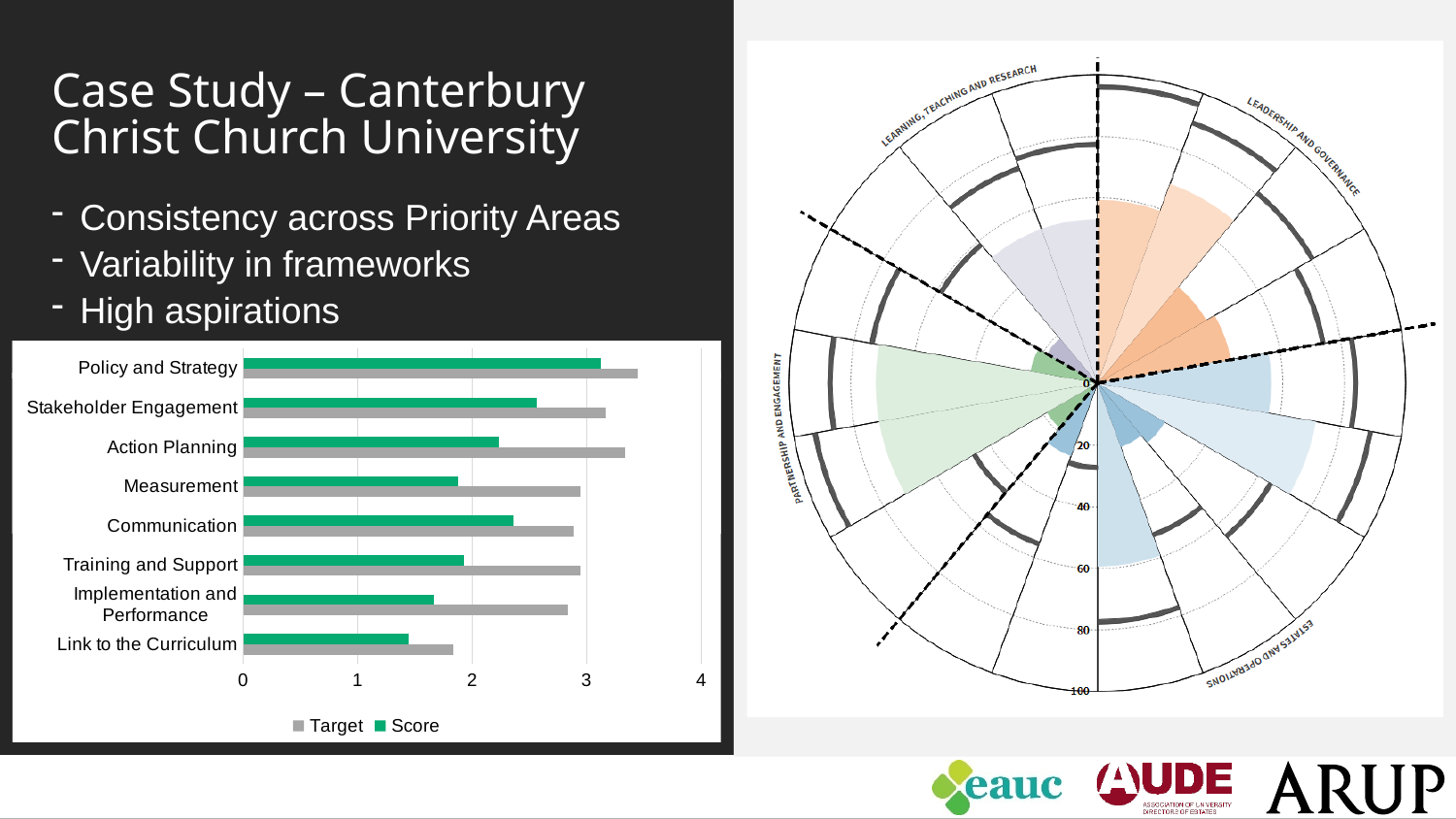
In the bar chart on the left, how many series does the legend list? 2 In the bar chart on the left, which category has the highest Score? Policy and Strategy In the bar chart on the left, which category has the lowest Score? Link to the Curriculum In the bar chart on the left, which is larger: the Score for Policy and Strategy or the Score for Link to the Curriculum? Policy and Strategy In the bar chart on the left, is the Target for Link to the Curriculum greater or less than 2? less In the bar chart on the left, is the Target for Policy and Strategy greater or less than 3? greater In the bar chart on the left, for Action Planning, which is larger: the Target or the Score? Target In the bar chart on the left, how many categories are shown? 8 In the bar chart on the left, what kind of chart is it? bar chart In the bar chart on the left, which category has the lowest Target? Link to the Curriculum In the bar chart on the left, what are the two legend entries? Target and Score In the bar chart on the left, is the Score for Implementation and Performance greater or less than 2? less